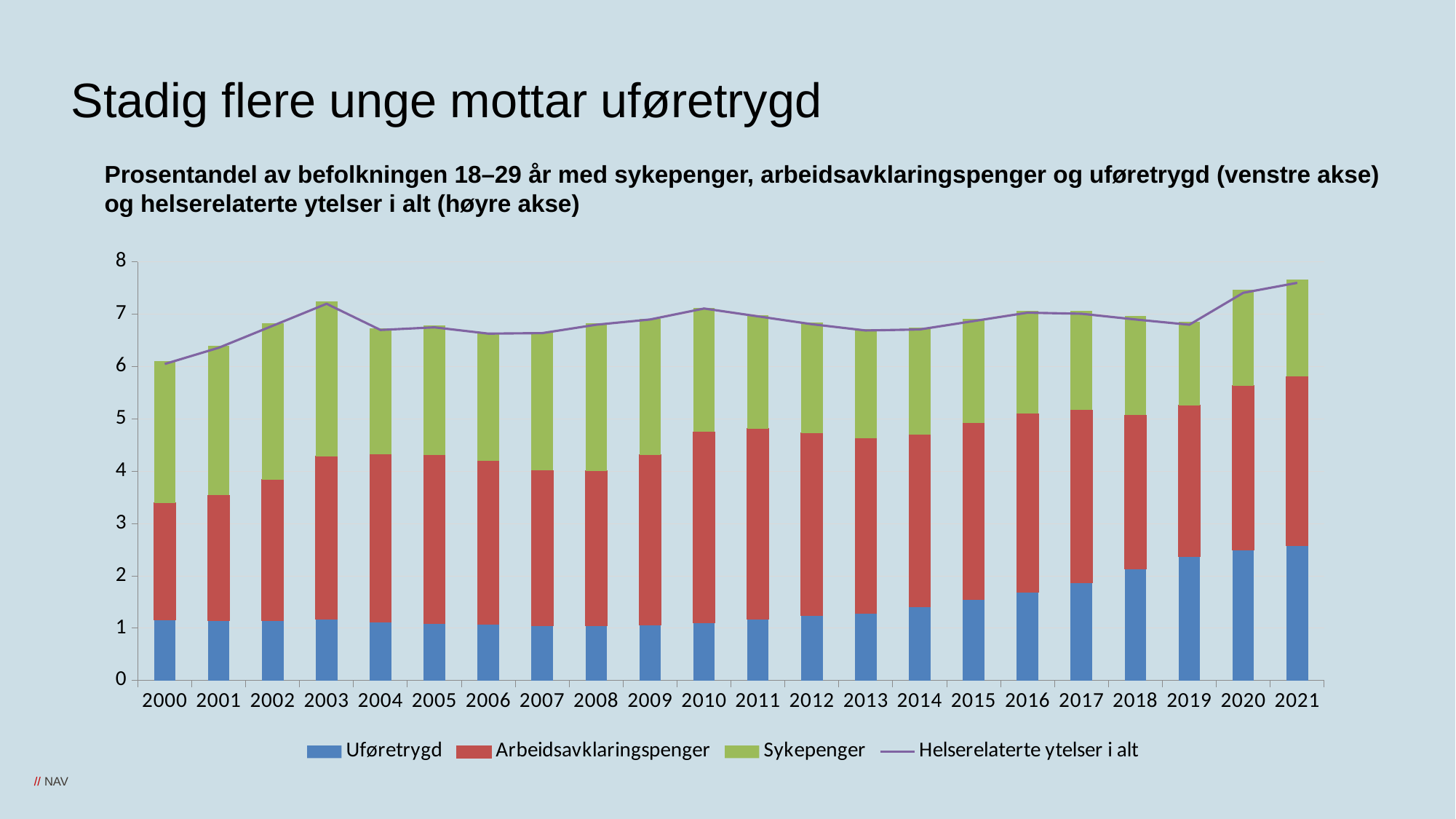
Which series is drawn as a line rather than bars? Helserelaterte ytelser i alt Is the total stacked bar for 2000 greater or less than 7? less How many years are shown on the x axis of the chart? 22 Which year has the lowest total stacked bar? 2000 Does the Uføretrygd series rise or fall from 2010 to 2021? rise Which is larger, the Uføretrygd value for 2021 or for 2000? 2021 Is the value for Uføretrygd in 2021 greater or less than 2? greater How many series does the legend list? 4 Which year has the highest value for Uføretrygd? 2021 Is the total stacked bar for 2021 greater or less than 7? greater What kind of chart is shown on the slide? Stacked bar chart with a line Which year has the highest total stacked bar? 2021